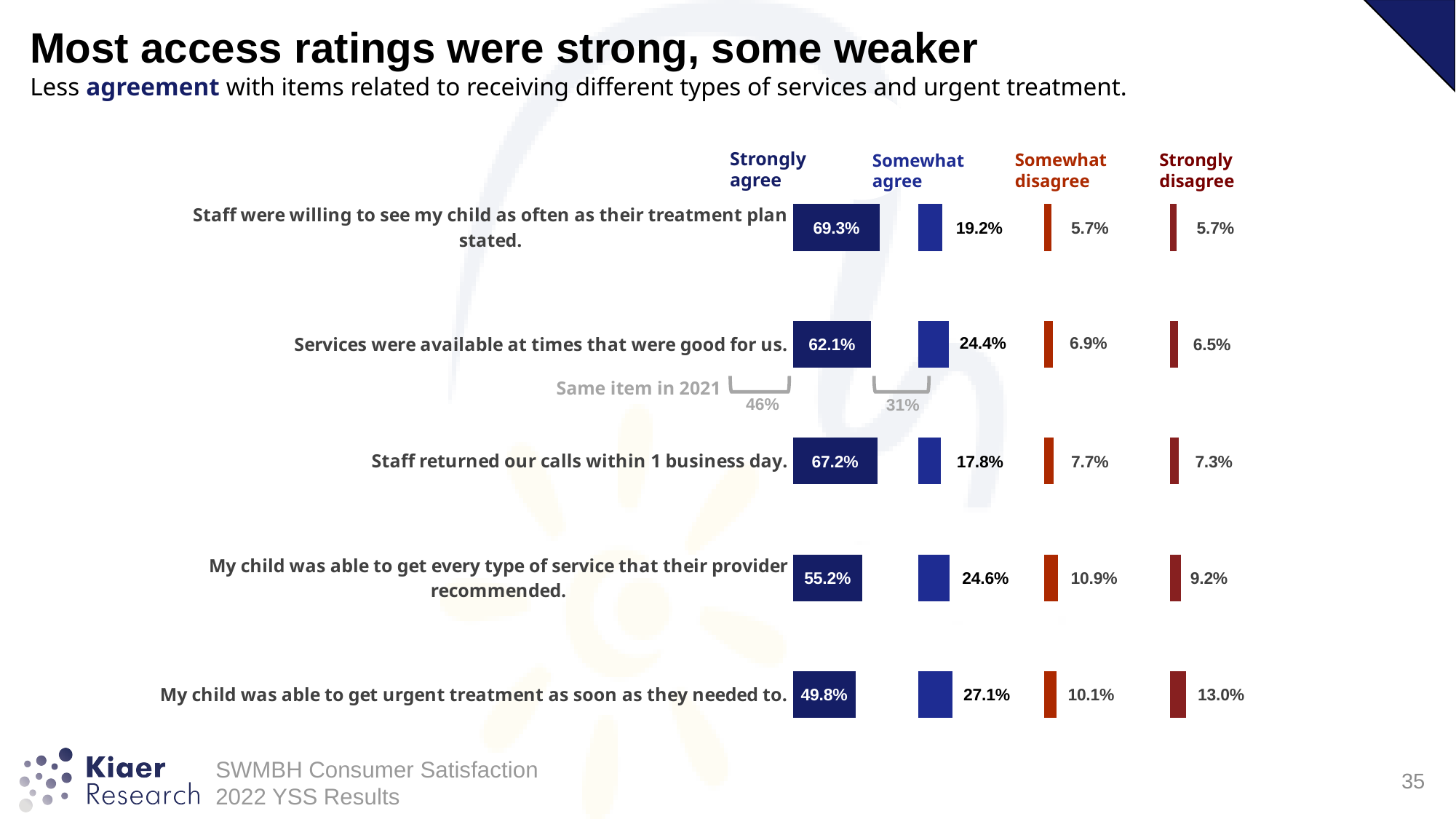
Which item has the highest 'Strongly disagree' percentage? My child was able to get urgent treatment as soon as they needed to. What percentage strongly disagreed that my child was able to get every type of service that their provider recommended? 9.2% What percentage somewhat agreed that my child was able to get urgent treatment as soon as they needed to? 27.1% What is the difference between the 'Strongly agree' percentages for 'Staff returned our calls within 1 business day' and 'My child was able to get urgent treatment as soon as they needed to'? 17.4% What percentage strongly agreed that staff were willing to see my child as often as their treatment plan stated? 69.3% How many response categories are shown across the top of the chart? 4 What percentage somewhat disagreed that services were available at times that were good for us? 6.9% What was the 'Strongly agree' percentage for the same item 'Services were available at times that were good for us' in 2021? 46% How many survey items are shown in the chart? 5 Which item has the lowest 'Strongly agree' percentage? My child was able to get urgent treatment as soon as they needed to. Which is larger: the 'Somewhat agree' percentage for 'Services were available at times that were good for us' or for 'Staff returned our calls within 1 business day'? Services were available at times that were good for us. Which item has the highest 'Strongly agree' percentage? Staff were willing to see my child as often as their treatment plan stated.